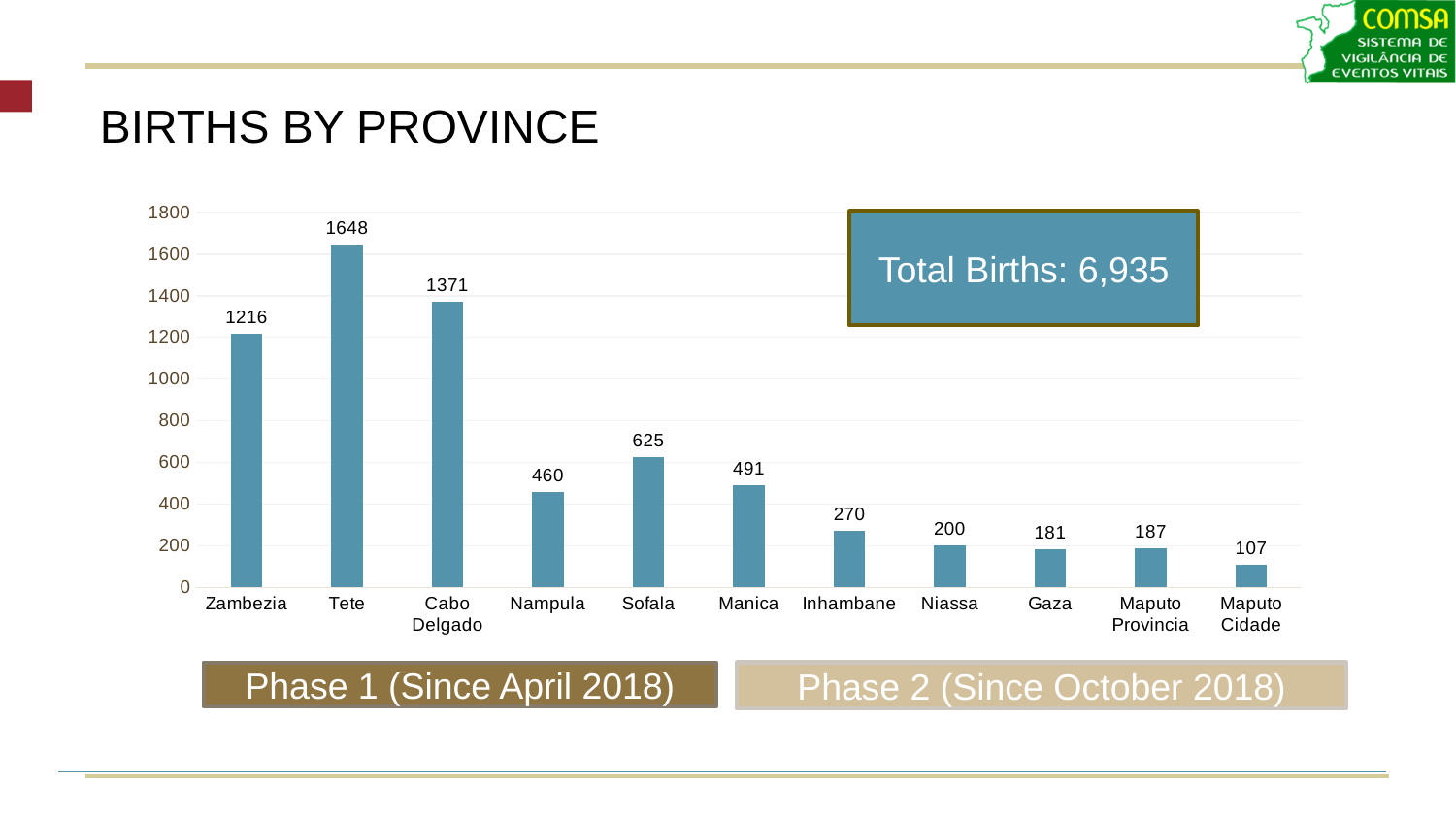
Which has more births, Sofala or Manica? Sofala What kind of chart is shown on the slide? bar chart What is the number of births for Inhambane? 270 How many provinces are shown on the chart? 11 What total number of births is stated in the box on the chart? 6,935 Is the value for Nampula greater or less than 600? less What is the number of births for Cabo Delgado? 1371 Which province has the lowest number of births? Maputo Cidade What is the difference in births between Tete and Zambezia? 432 Which province has the highest number of births? Tete What is the title of the chart? BIRTHS BY PROVINCE What is the number of births for Tete? 1648